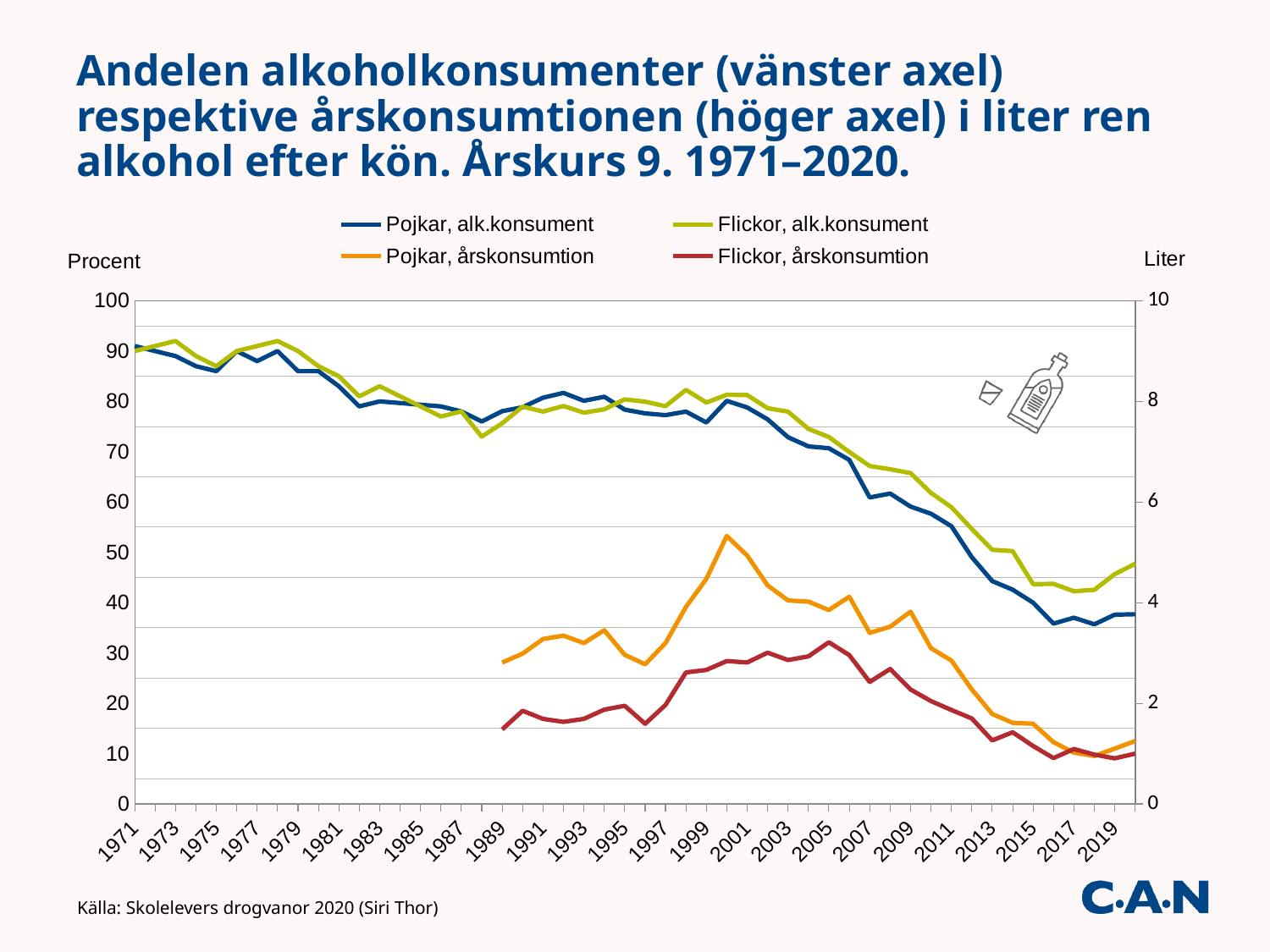
Is the value for Pojkar, årskonsumtion in 2000 greater or less than 4 liter? greater Does the Flickor, alk.konsument series rise or fall from 2017 to 2020? rise How many series does the legend list? 4 Is the value for Pojkar, alk.konsument in 1971 greater or less than 80? greater Is the value for Flickor, alk.konsument in 2019 greater or less than 50? less In 2019, which is higher: Flickor, alk.konsument or Pojkar, alk.konsument? Flickor, alk.konsument Does the Pojkar, alk.konsument series rise or fall overall from 1971 to 2020? fall In which year does the Pojkar, årskonsumtion series reach its highest value? 2000 What is the label of the right-hand axis? Liter In 2005, which is higher: Pojkar, årskonsumtion or Flickor, årskonsumtion? Pojkar, årskonsumtion What kind of chart is shown on the slide? line chart